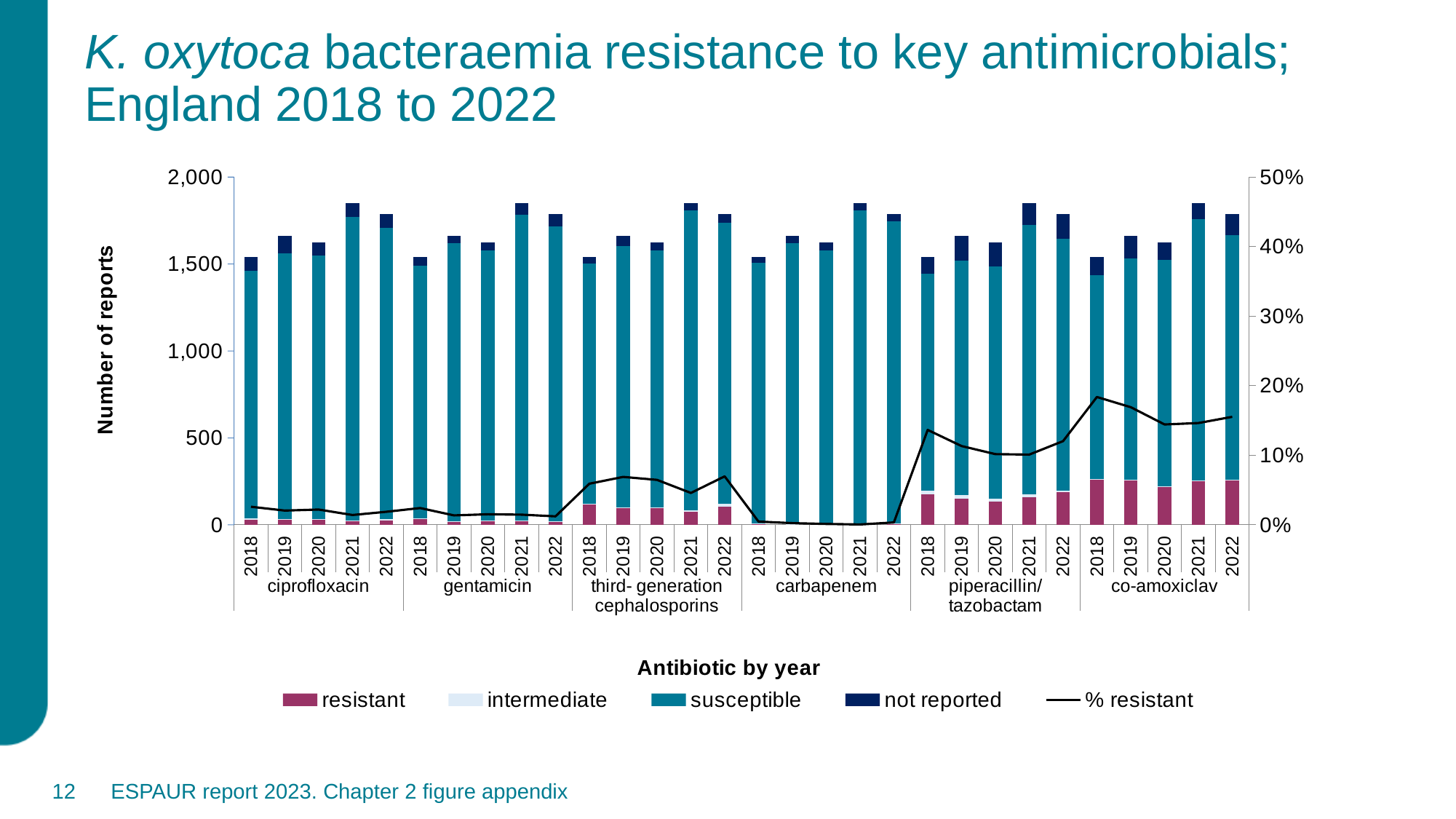
Which antibiotic group has the highest % resistant values? co-amoxiclav How many years are shown for each antibiotic group? 5 What is the label of the left vertical axis? Number of reports How many series does the legend list? 5 Is the total number of reports for ciprofloxacin in 2021 greater or less than 1,500? greater Is the % resistant for carbapenem in 2020 greater or less than 10%? less How many antibiotic groups are shown along the x axis? 6 Is the total number of reports for gentamicin in 2022 greater or less than 2,000? less Which antibiotic group has the lowest % resistant values? carbapenem What kind of chart is shown on the slide? Stacked bar chart with a line Which is larger, the % resistant for co-amoxiclav in 2018 or for ciprofloxacin in 2018? co-amoxiclav in 2018